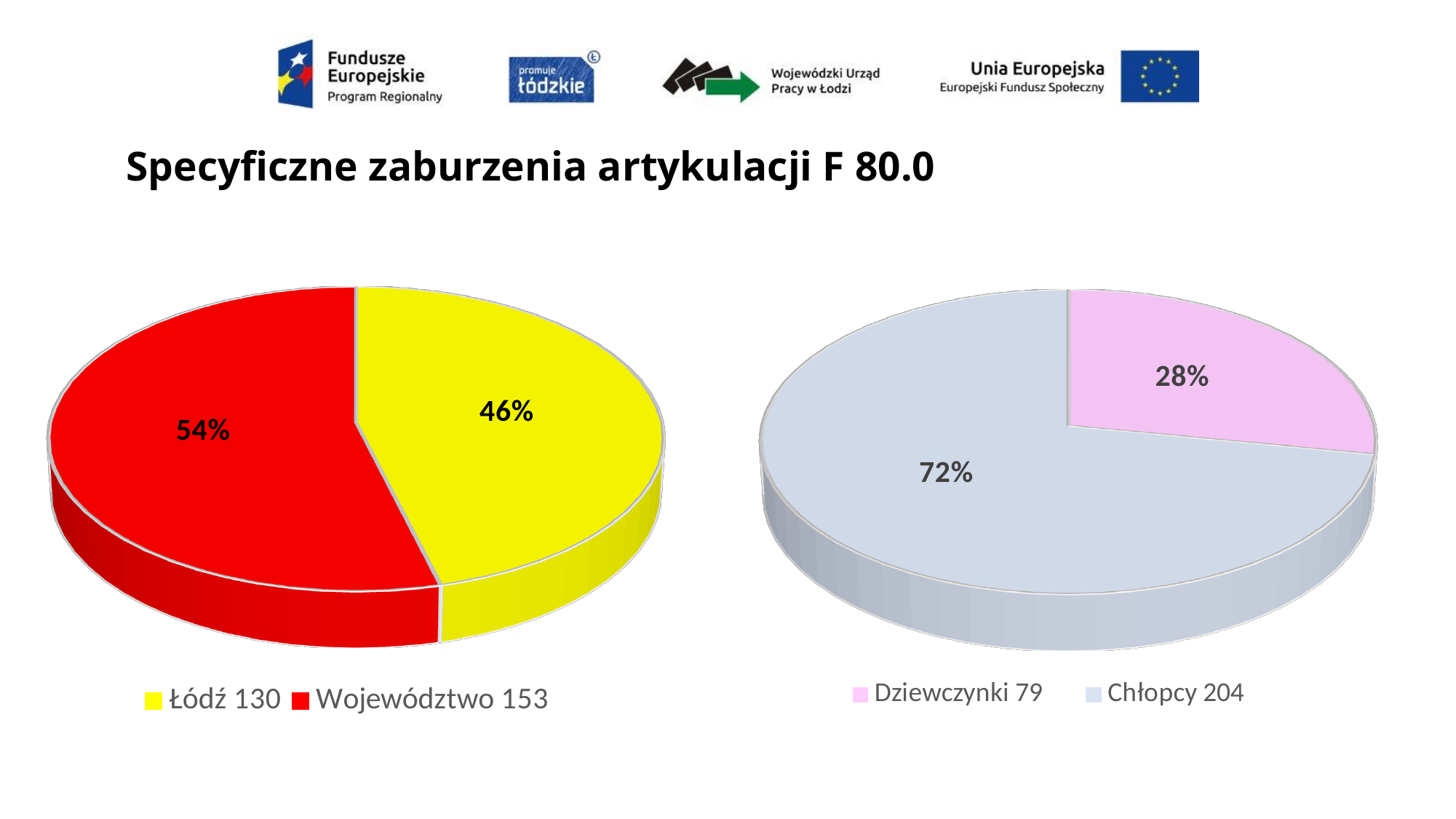
In the left pie chart, what share does Łódź have? 46% In the left pie chart, what count is shown for Łódź in the legend? 130 In the left pie chart, which slice is larger, Łódź or Województwo? Województwo How many slices does the right pie chart have? 2 What kind of chart is the left chart on the slide? pie chart In the right pie chart, what share do Chłopcy have? 72% In the left pie chart, what share does Województwo have? 54% In the left pie chart, what count is shown for Województwo in the legend? 153 In the right pie chart, what count is shown for Chłopcy in the legend? 204 In the left pie chart, what is the difference between the Województwo count and the Łódź count? 23 In the right pie chart, which slice is the largest? Chłopcy